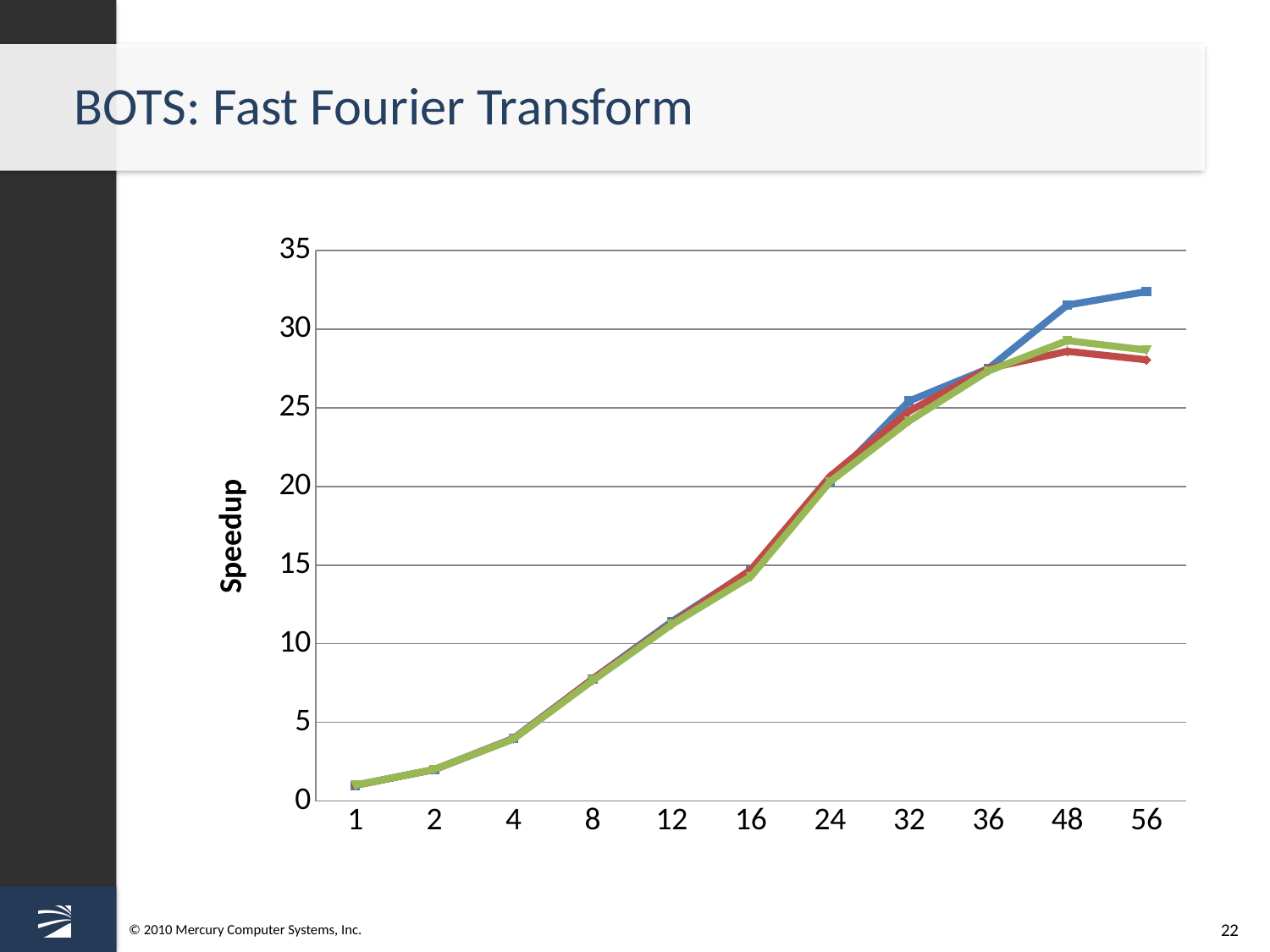
At x = 56, is the blue line's speedup greater or less than 30? greater At x = 8, is the speedup greater or less than 10? less At x = 56, which is larger: the blue line's speedup or the red line's speedup? the blue line's speedup What is the label of the vertical axis? Speedup Does the blue line's speedup generally rise or fall as the x-axis value increases? rise How many lines are plotted on the chart? 3 At which x-axis value does the blue line reach its lowest speedup? 1 What kind of chart is shown on the slide? line chart How many x-axis categories (thread counts) are plotted on the chart? 11 At x = 36, is the speedup greater or less than 25? greater Which line has the highest speedup at x = 56? the blue line